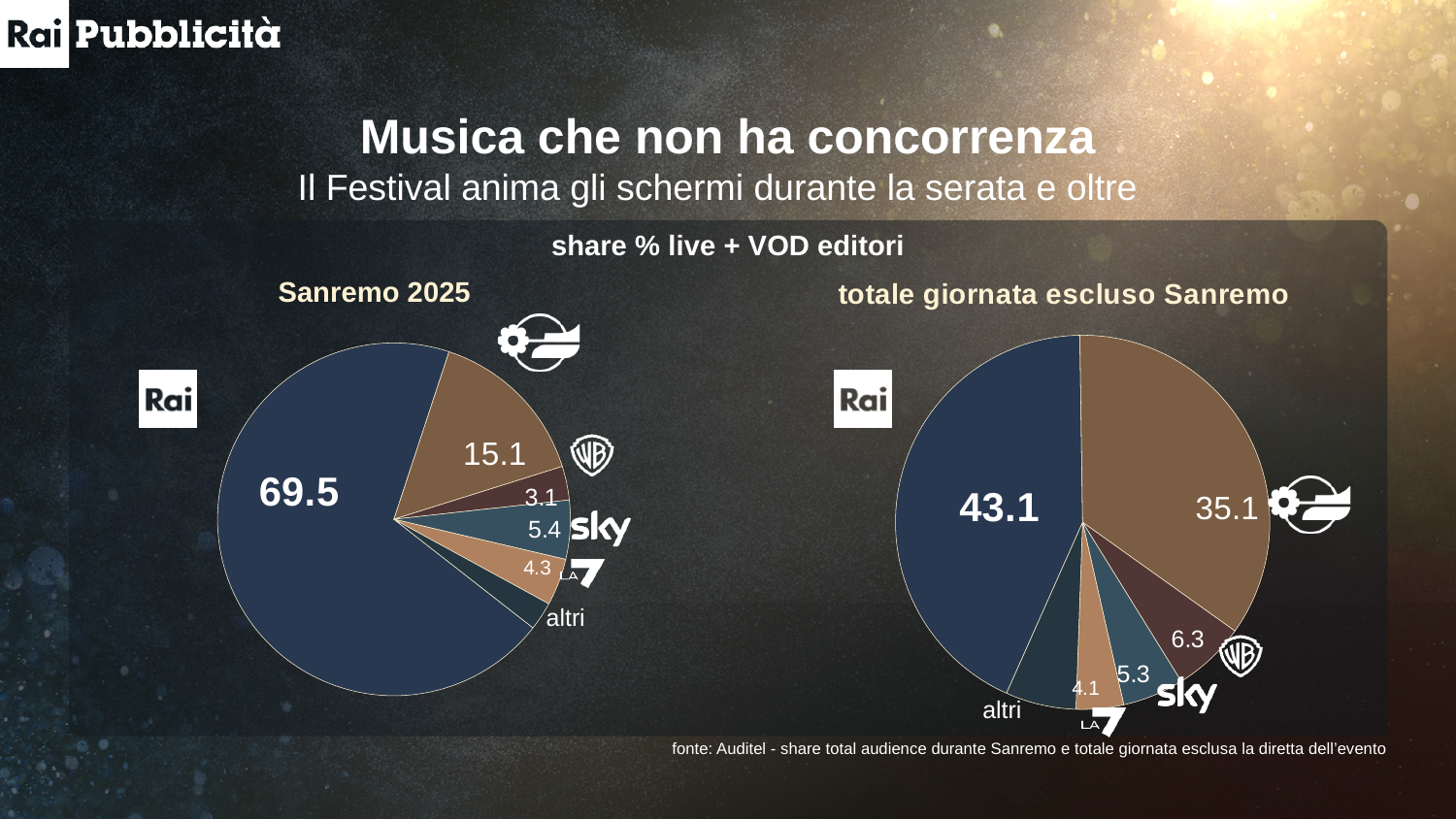
In the Sanremo 2025 pie chart, what is the share for Rai? 69.5 What is the difference between the Rai share in the Sanremo 2025 chart and the Rai share in the 'totale giornata escluso Sanremo' chart? 26.4 In the Sanremo 2025 pie chart, what is the difference between the Sky share and the La7 share? 1.1 In the Sanremo 2025 pie chart, what is the share for Sky? 5.4 In the 'totale giornata escluso Sanremo' pie chart, what is the share for Rai? 43.1 In the Sanremo 2025 pie chart, which editor has the largest slice? Rai In the Sanremo 2025 pie chart, what is the share for La7? 4.3 In the 'totale giornata escluso Sanremo' pie chart, what is the share for Warner Bros? 6.3 In the 'totale giornata escluso Sanremo' pie chart, what is the share for La7? 4.1 In the Sanremo 2025 pie chart, what is the share for Warner Bros? 3.1 What type of chart is used for the Sanremo 2025 data? Pie chart Is the Rai share larger in the Sanremo 2025 chart or in the 'totale giornata escluso Sanremo' chart? Sanremo 2025